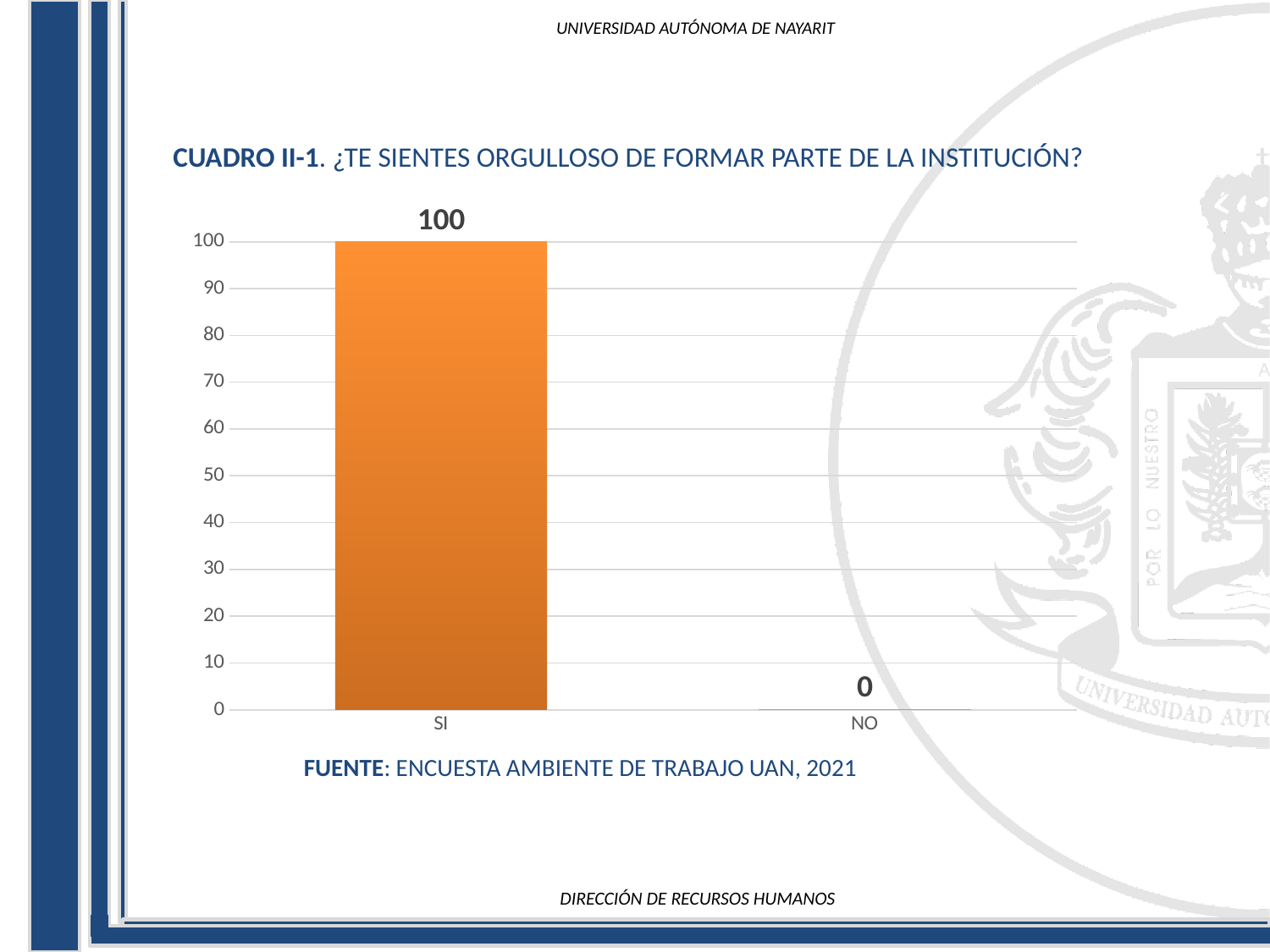
Which category has the lowest value? NO What is the difference between the values for SI and NO? 100 What is the value for NO? 0 Which is larger, the value for SI or the value for NO? SI What kind of chart is shown on the slide? bar chart What is the value for SI? 100 How many categories are shown on the x axis? 2 What is the title of the chart? CUADRO II-1. ¿TE SIENTES ORGULLOSO DE FORMAR PARTE DE LA INSTITUCIÓN? Do the values rise or fall from SI to NO? fall What source is cited below the chart? ENCUESTA AMBIENTE DE TRABAJO UAN, 2021 Is the value for SI greater or less than 50? greater Which category has the highest value? SI